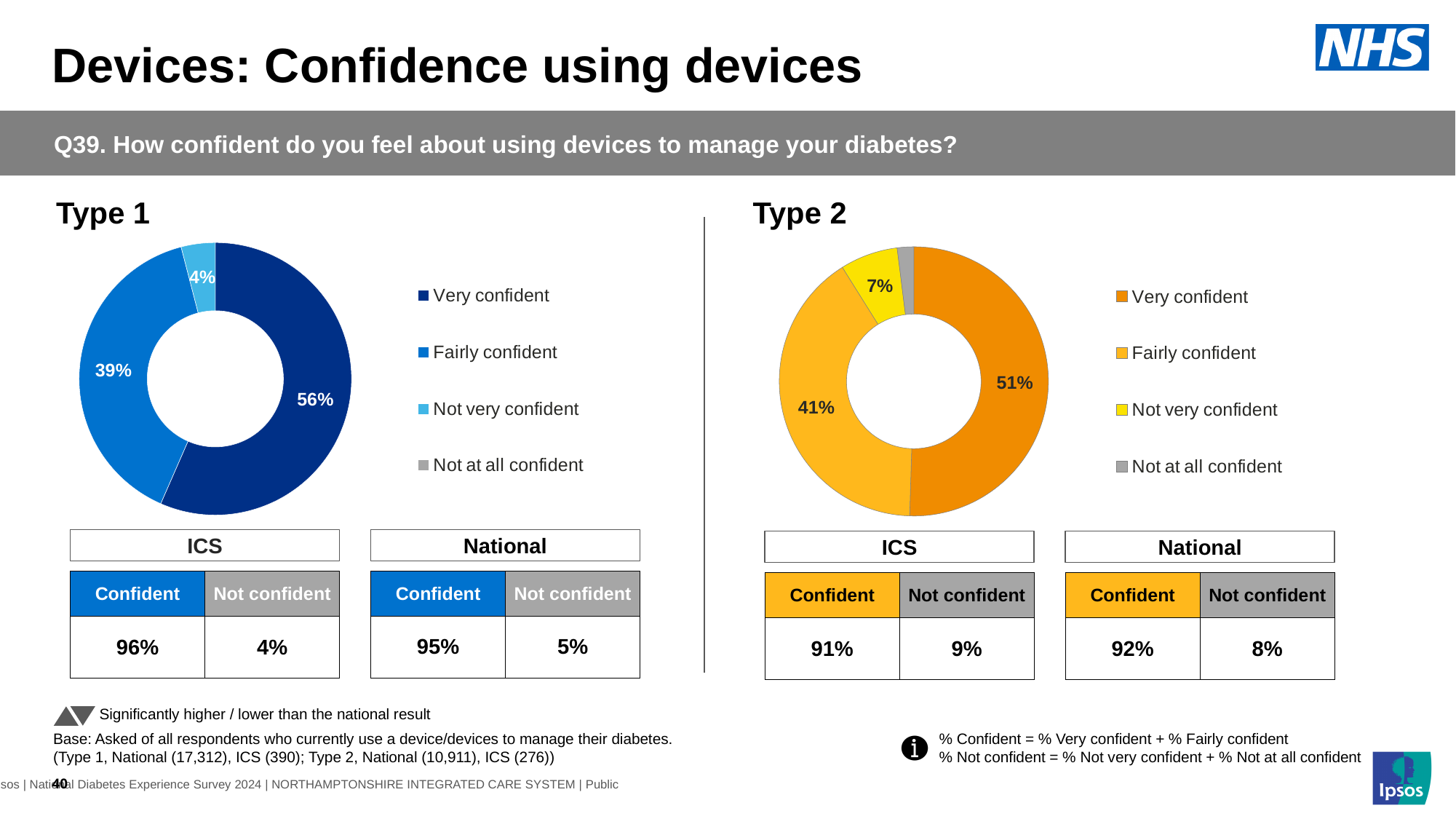
In the Type 2 chart, which category has the largest share? Very confident In the Type 1 chart, what percentage of respondents are fairly confident? 39% In the Type 2 chart, what percentage of respondents are fairly confident? 41% In the Type 1 chart, what percentage of respondents are not very confident? 4% What kind of chart is used for Type 1? Doughnut chart In the Type 2 chart, what is the difference between the very confident and fairly confident shares? 10% In the Type 2 chart, what percentage of respondents are not very confident? 7% In the Type 1 chart, what percentage of respondents are very confident? 56% In the Type 2 chart, what percentage of respondents are very confident? 51% How many entries does the legend of the Type 2 chart list? 4 In the Type 1 chart, which category has the largest share? Very confident In the Type 1 chart, what is the difference between the very confident and fairly confident shares? 17%